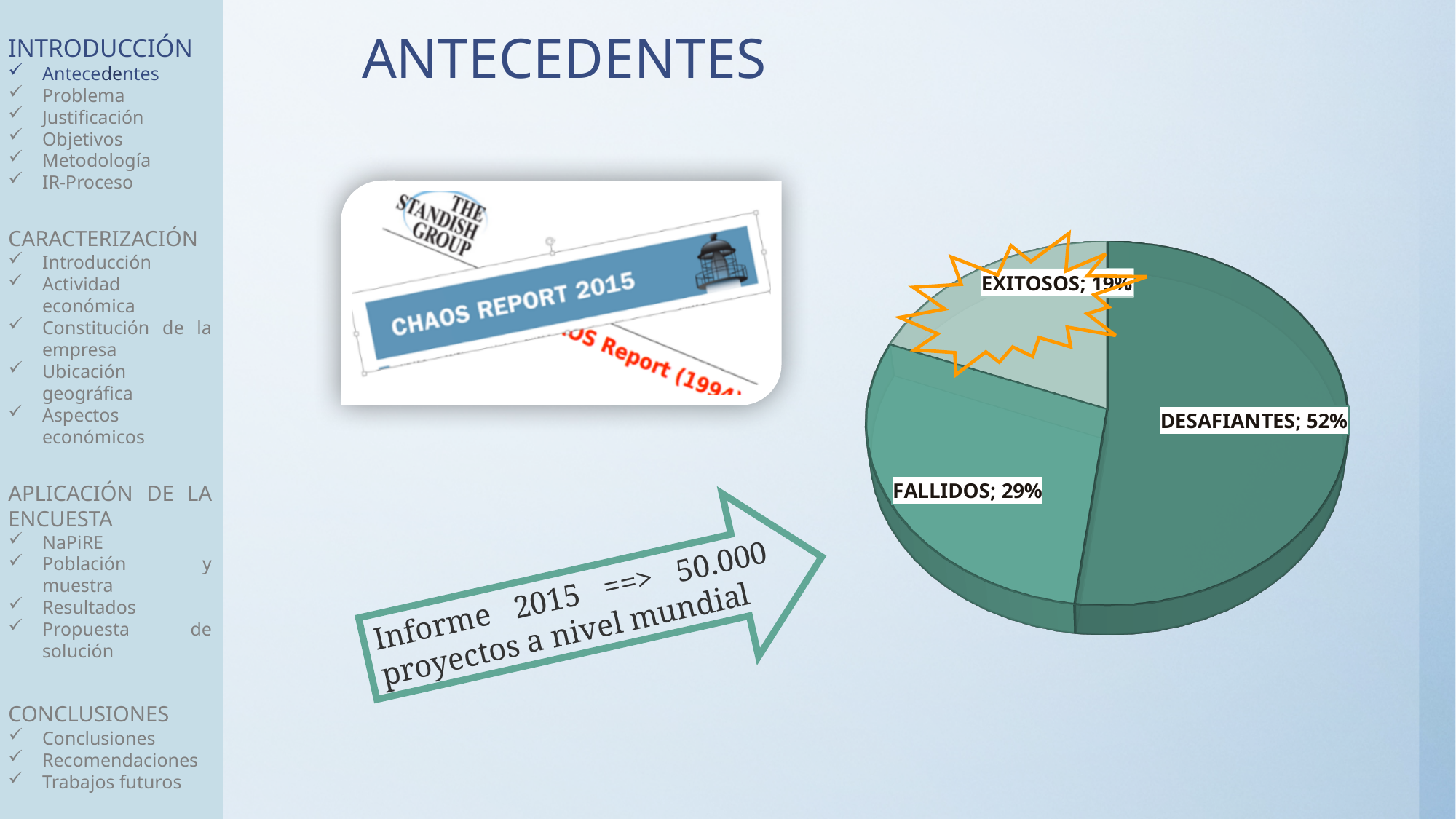
How many slices does the pie chart have? 3 What is the difference in percentage points between DESAFIANTES and FALLIDOS? 23 What kind of chart is shown on the slide? pie chart Which is larger, the FALLIDOS slice or the EXITOSOS slice? FALLIDOS What is the difference in percentage points between FALLIDOS and EXITOSOS? 10 What percentage of projects are labelled EXITOSOS in the pie chart? 19% Is the DESAFIANTES slice more or less than half of the pie? more Which category has the smallest slice of the pie chart? EXITOSOS Which slice of the pie chart is highlighted with an orange starburst outline? EXITOSOS What percentage of projects are labelled DESAFIANTES in the pie chart? 52% What percentage of projects are labelled FALLIDOS in the pie chart? 29% Which category has the largest slice of the pie chart? DESAFIANTES